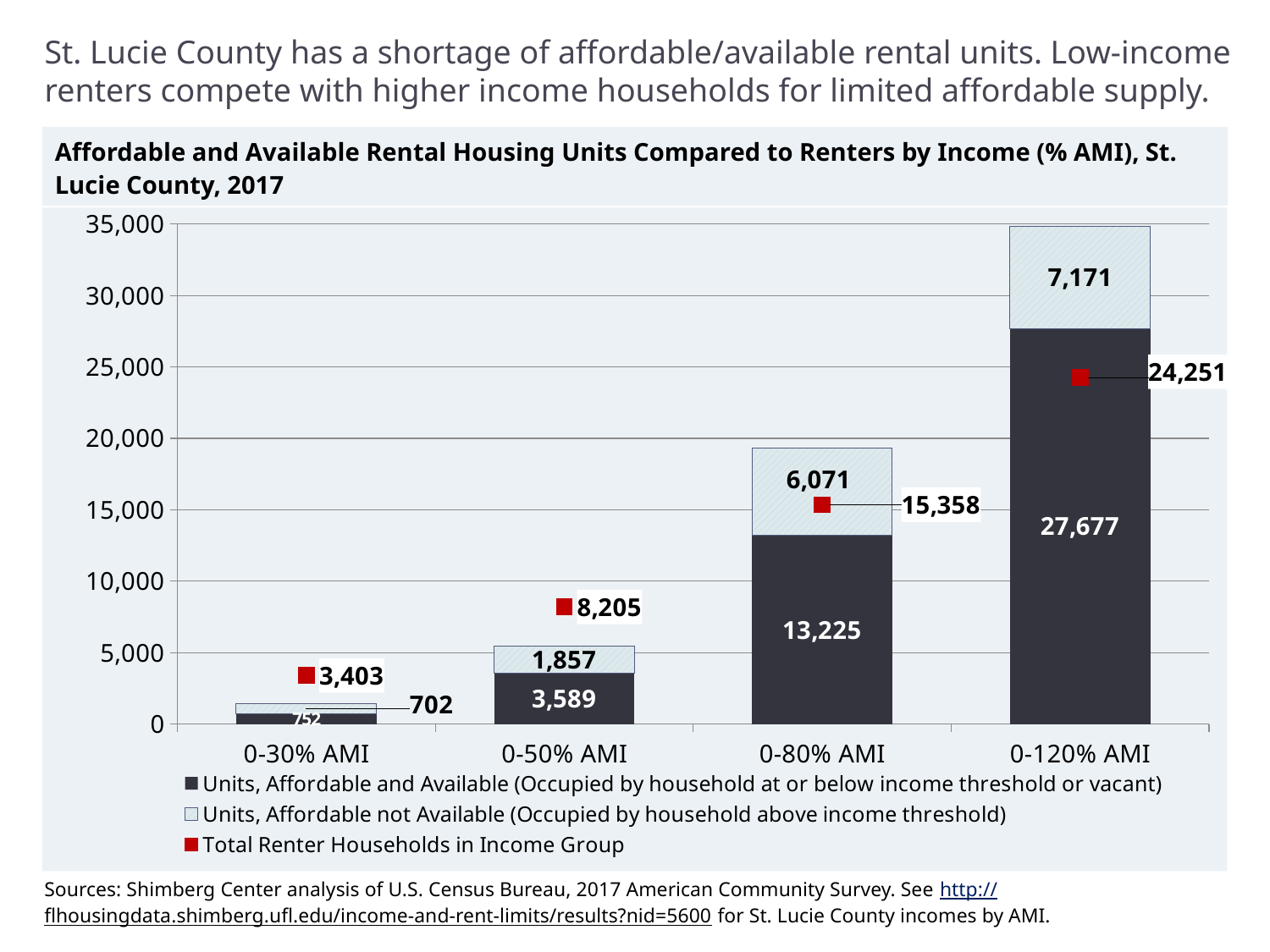
Which income group has the highest value for Units, Affordable and Available? 0-120% AMI How many income group categories are shown on the x axis? 4 Which income group has the lowest value for Total Renter Households in Income Group? 0-30% AMI For 0-120% AMI, which is larger: Units, Affordable and Available or Total Renter Households in Income Group? Units, Affordable and Available Do the values for Total Renter Households in Income Group rise or fall from 0-30% AMI to 0-120% AMI? Rise What is the value of Total Renter Households in Income Group for 0-50% AMI? 8,205 What is the total of the stacked bar for 0-50% AMI (Affordable and Available plus Affordable not Available)? 5,446 How many series does the legend list? 3 For 0-80% AMI, what is the difference between Total Renter Households in Income Group and Units, Affordable and Available? 2,133 What kind of chart is shown on the slide? Bar chart What is the value of Units, Affordable and Available for 0-80% AMI? 13,225 What is the value of Units, Affordable not Available for 0-120% AMI? 7,171